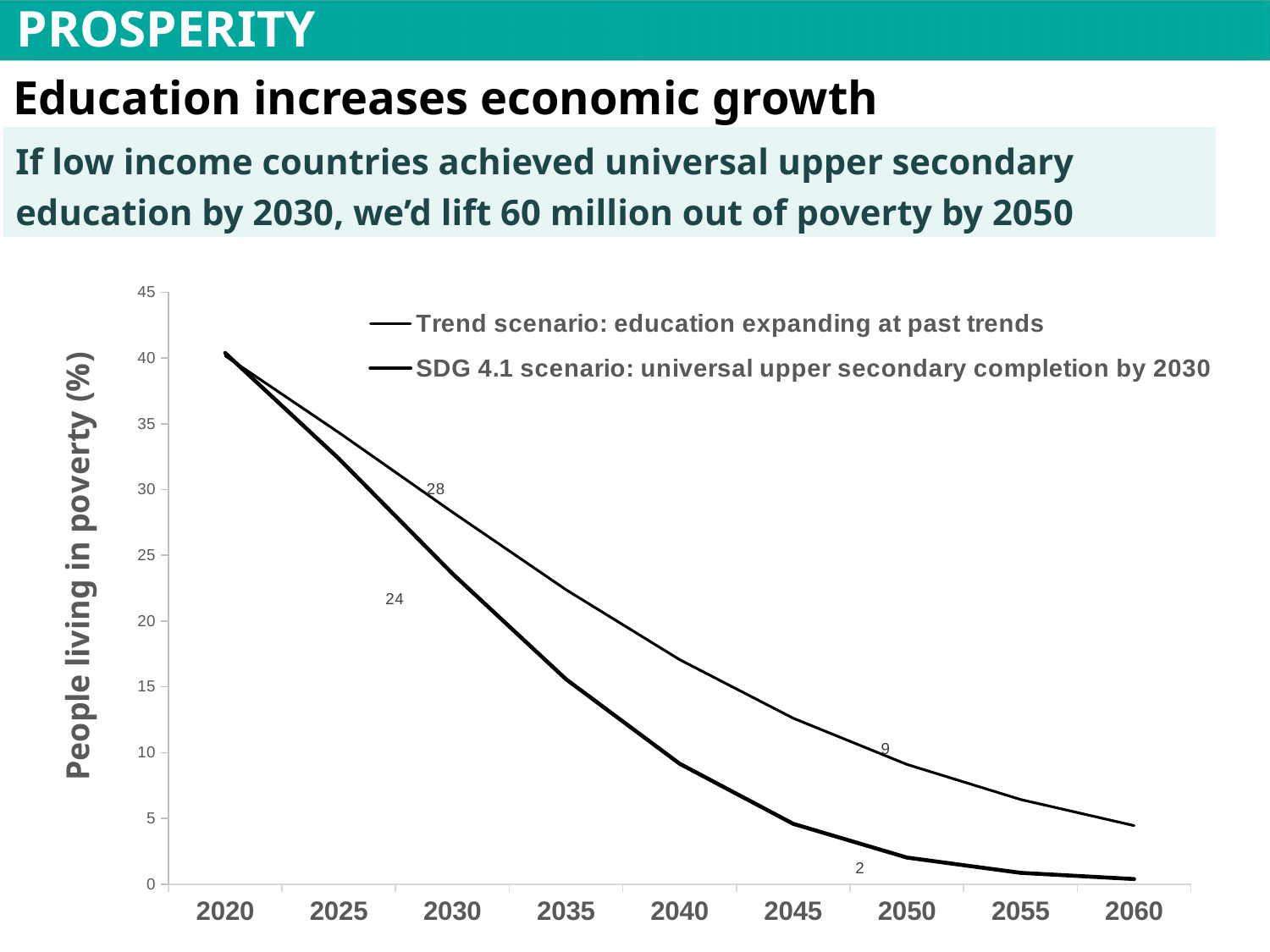
What is the value for the SDG 4.1 scenario in 2050? 2 What is the difference between the Trend scenario and the SDG 4.1 scenario in 2050? 7 Is the value for the Trend scenario in 2040 greater or less than 15? greater What is the difference between the Trend scenario and the SDG 4.1 scenario in 2030? 4 Is the value for the SDG 4.1 scenario in 2060 greater or less than 5? less How many series does the legend list? 2 What is the value for the SDG 4.1 scenario in 2030? 24 Do the values for the SDG 4.1 scenario rise or fall from 2020 to 2060? Fall What kind of chart is shown on the slide? Line chart What is the value for the Trend scenario in 2030? 28 What is the value for the Trend scenario in 2050? 9 In 2050, which scenario has the higher share of people living in poverty? Trend scenario